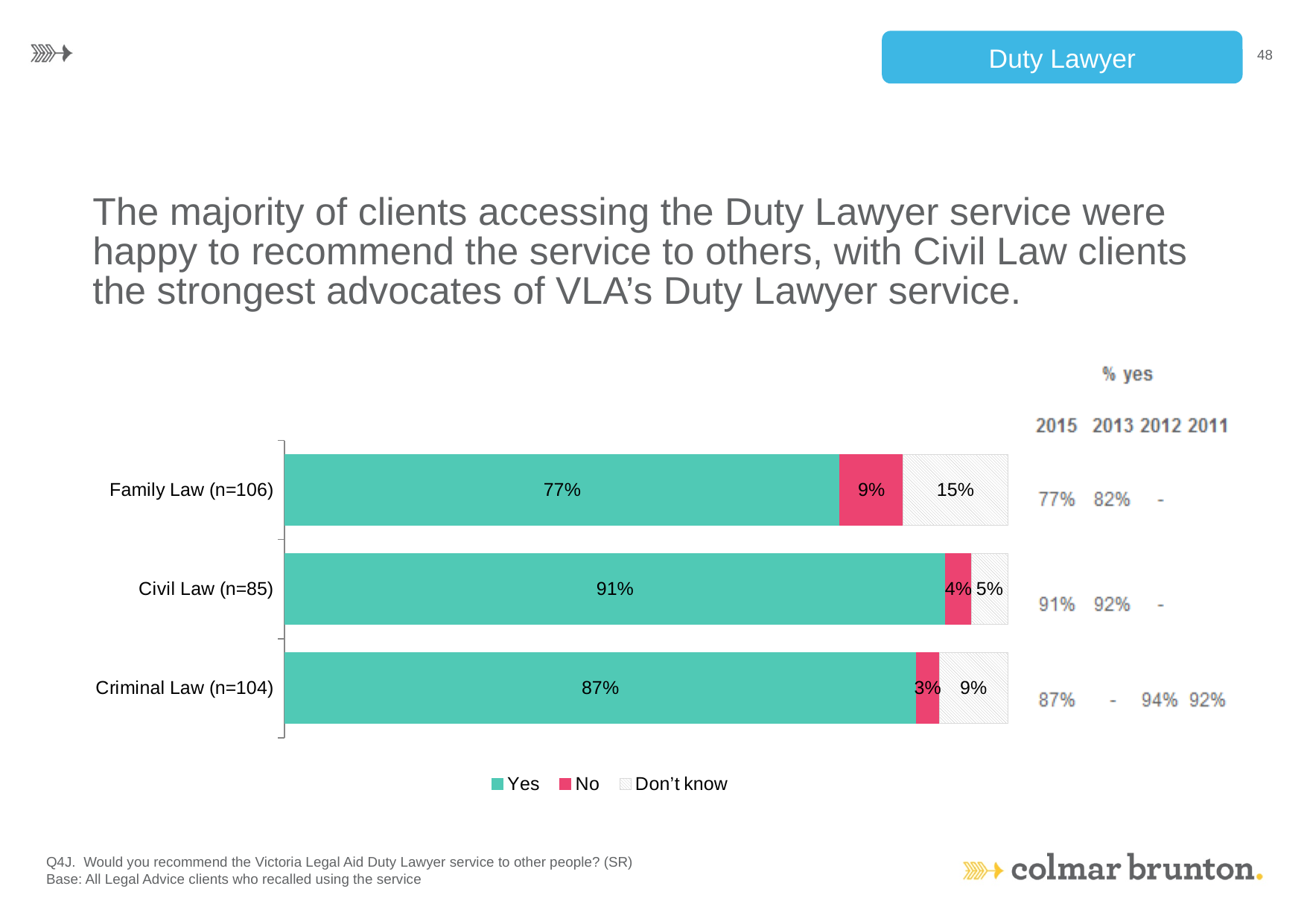
What percentage of Civil Law clients answered No? 4% Which category has the lowest Yes percentage? Family Law (n=106) What percentage of Criminal Law clients answered Don't know? 9% What is the difference between the Yes percentage for Civil Law and Family Law? 14 percentage points What is the total of the Family Law bar (Yes + No + Don't know)? 101% What kind of chart is shown on the slide? Stacked bar chart Which is larger: the No percentage for Family Law or for Criminal Law? Family Law What percentage of Family Law clients said Yes to recommending the Duty Lawyer service? 77% What was the % yes for Criminal Law in 2012 according to the table on the right? 94% How many series does the legend list? 3 How many categories are shown in the bar chart? 3 Which category has the highest Yes percentage? Civil Law (n=85)